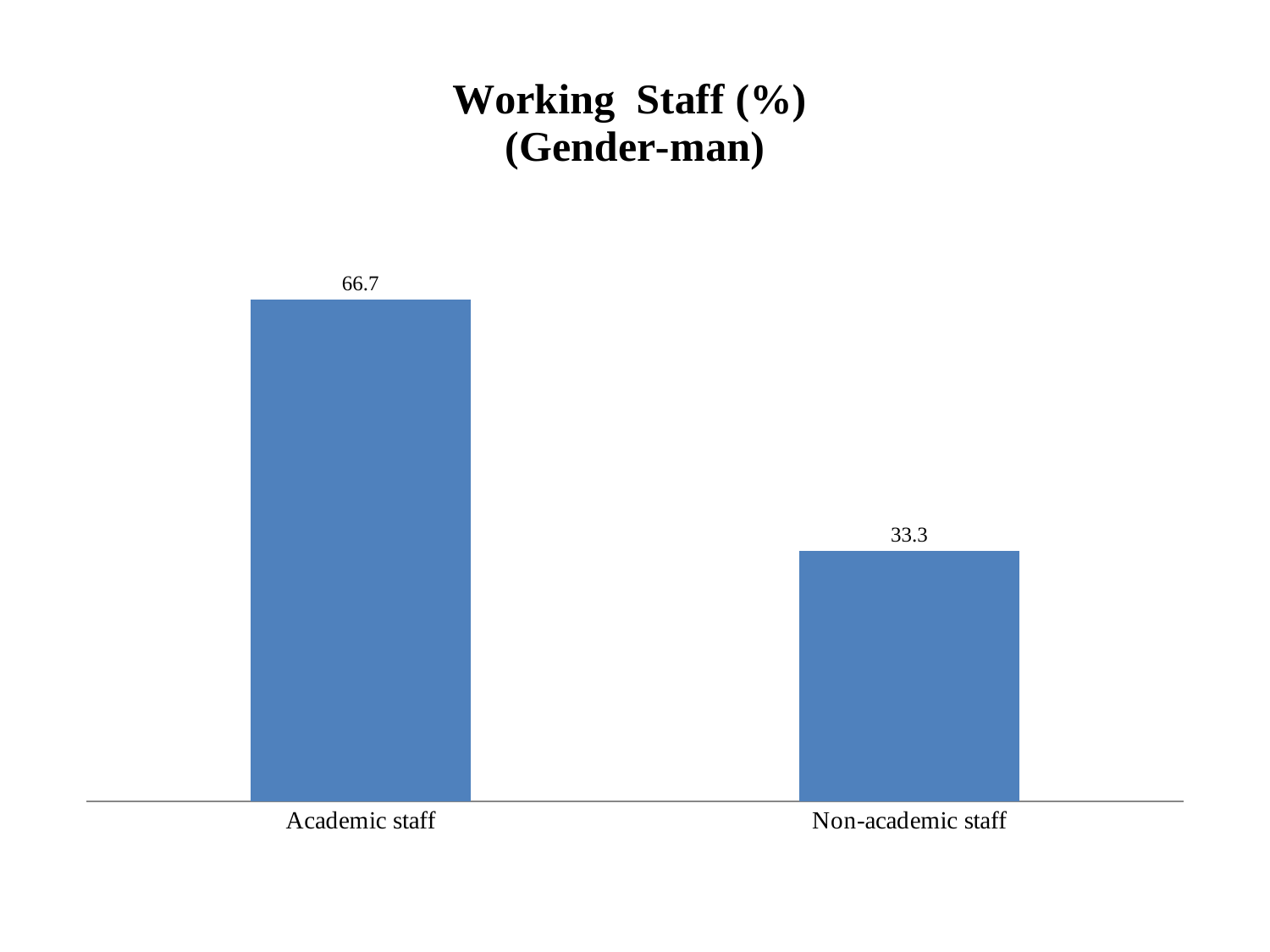
How many categories are shown in the chart? 2 Which category has the highest value? Academic staff What is the value for Academic staff? 66.7 Which category has the lowest value? Non-academic staff What is the difference between the values for Academic staff and Non-academic staff? 33.4 What kind of chart is shown on the slide? Bar chart What is the value for Non-academic staff? 33.3 What colour are the bars in the chart? Blue What is the title of the chart? Working Staff (%) (Gender-man) Which is larger, the value for Academic staff or the value for Non-academic staff? Academic staff What is the total of the two values shown in the chart? 100